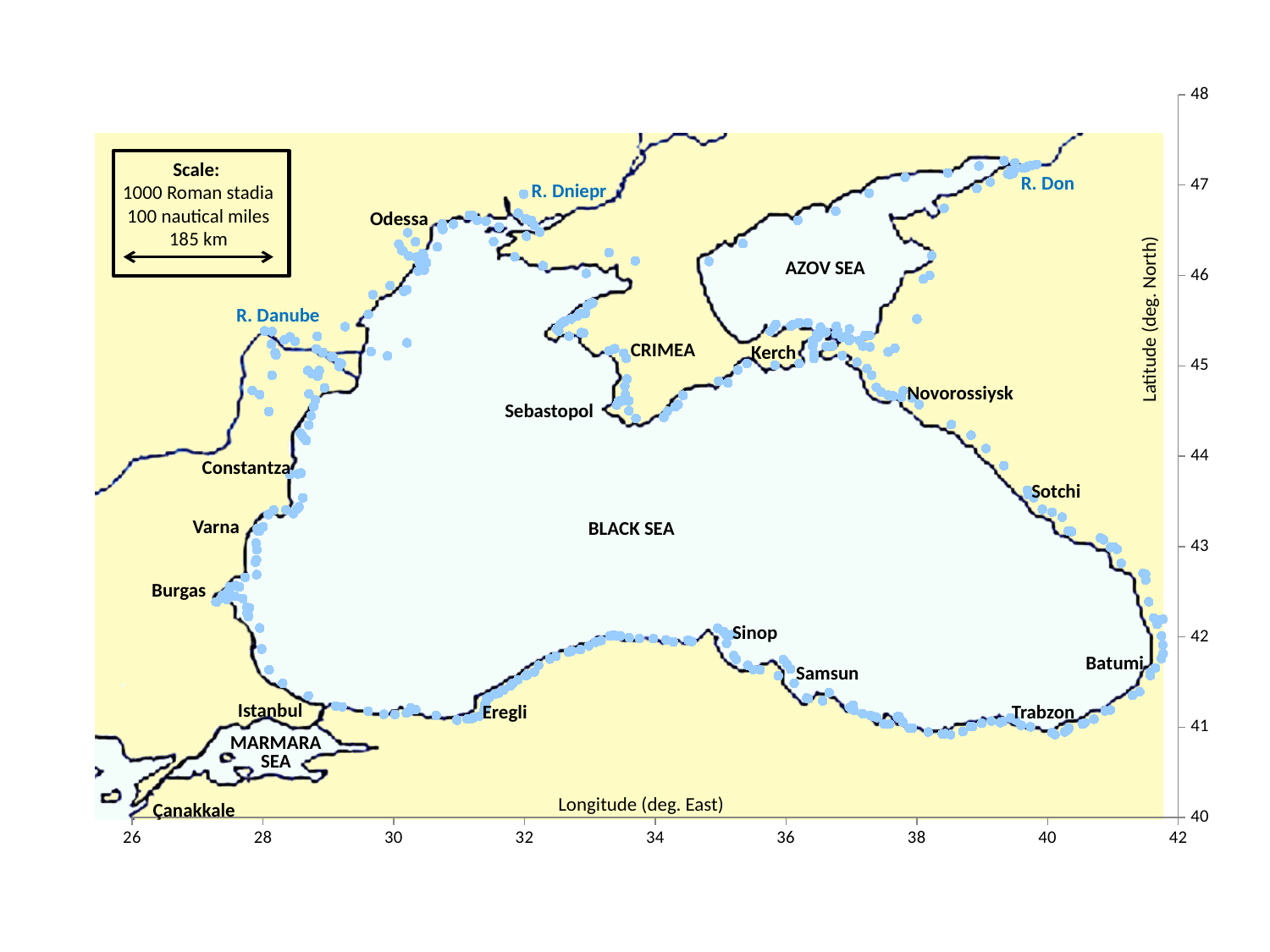
Is the latitude of the points near Sinop greater or less than 43? less What is the title of the horizontal axis? Longitude (deg. East) What is the maximum value shown on the latitude axis? 48 What is the minimum value shown on the longitude axis? 26 Is the latitude of the points near Odessa greater or less than 46? greater Is the longitude of the points near Burgas greater or less than 30? less What kind of chart is shown on the slide? scatter chart What is the title of the vertical axis? Latitude (deg. North)